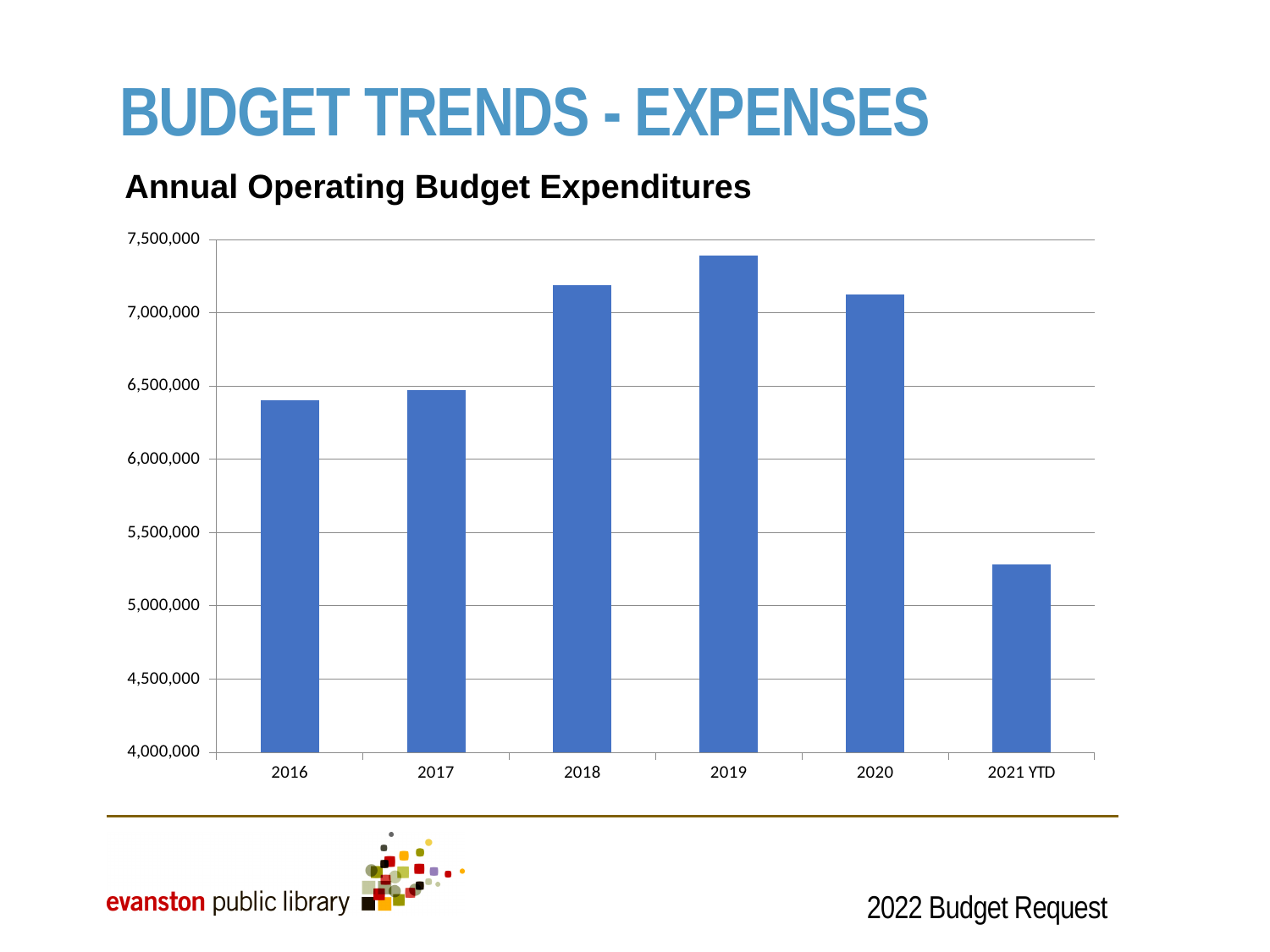
What kind of chart is shown on the slide? bar chart What is the title of the chart? Annual Operating Budget Expenditures How many years (categories) are shown on the x axis of the chart? 6 Which year has the highest annual operating budget expenditure? 2019 Which is larger, the expenditure for 2018 or for 2016? 2018 Do the expenditures rise or fall from 2016 to 2019? rise Is the value for 2018 greater or less than 7,000,000? greater Which category has the lowest annual operating budget expenditure? 2021 YTD Is the value for 2021 YTD greater or less than 5,500,000? less Is the value for 2019 greater or less than 7,000,000? greater Which is larger, the expenditure for 2020 or for 2021 YTD? 2020